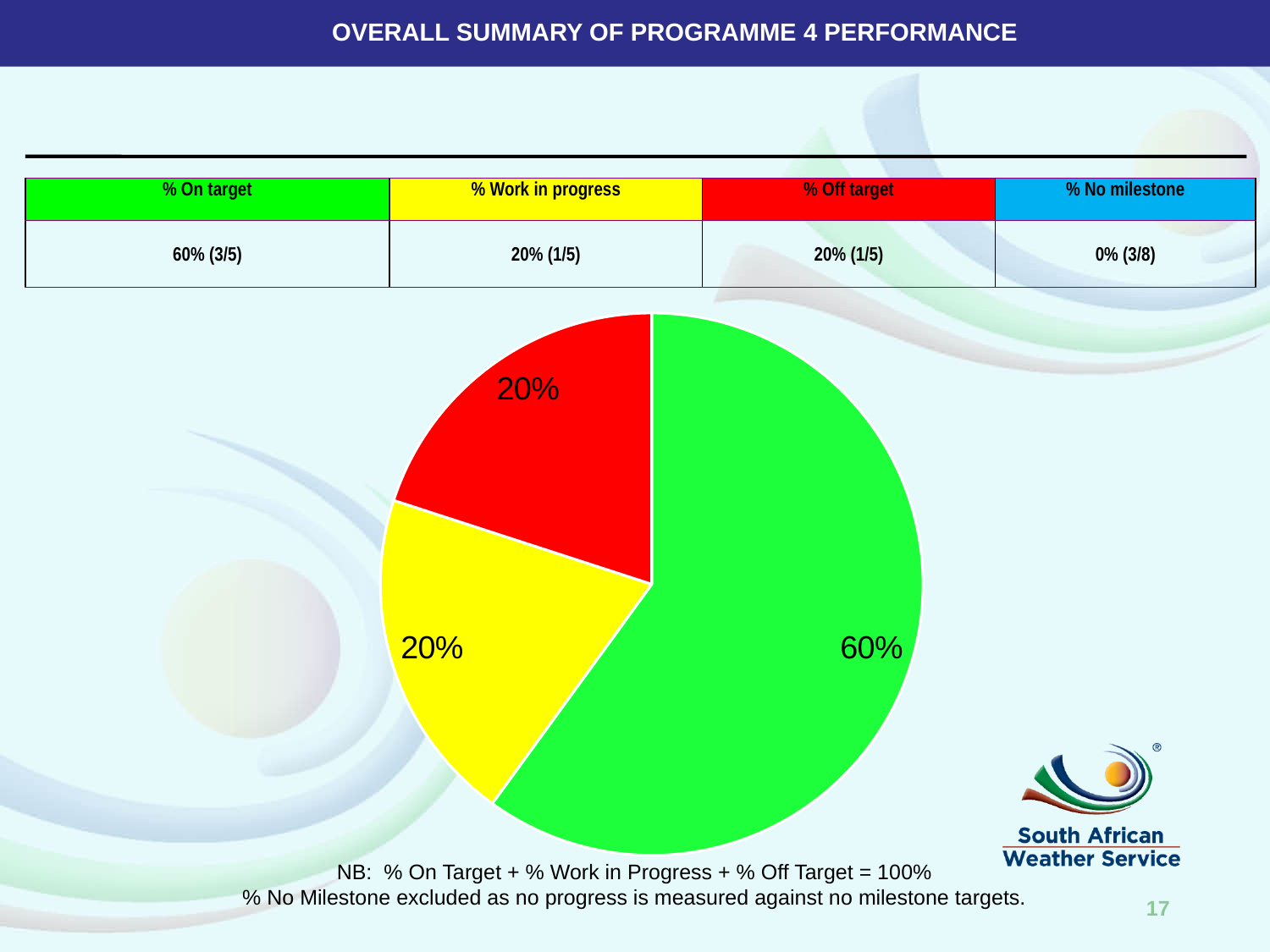
What percentage is shown on the green slice of the pie chart? 60% Which colour slice is the largest in the pie chart? green What is the difference between the green slice and the yellow slice in the pie chart? 40% What percentage is shown on the yellow slice of the pie chart? 20% According to the table above the chart, what percentage of targets are off target? 20% (1/5) How many slices does the pie chart have? 3 Which colour in the table represents '% Work in progress'? yellow What kind of chart is shown on the slide? pie chart According to the table above the chart, what percentage of targets are on target? 60% (3/5) What percentage is shown on the red slice of the pie chart? 20% What is the title of the slide containing the pie chart? OVERALL SUMMARY OF PROGRAMME 4 PERFORMANCE Is the green slice larger or smaller than the red slice? larger